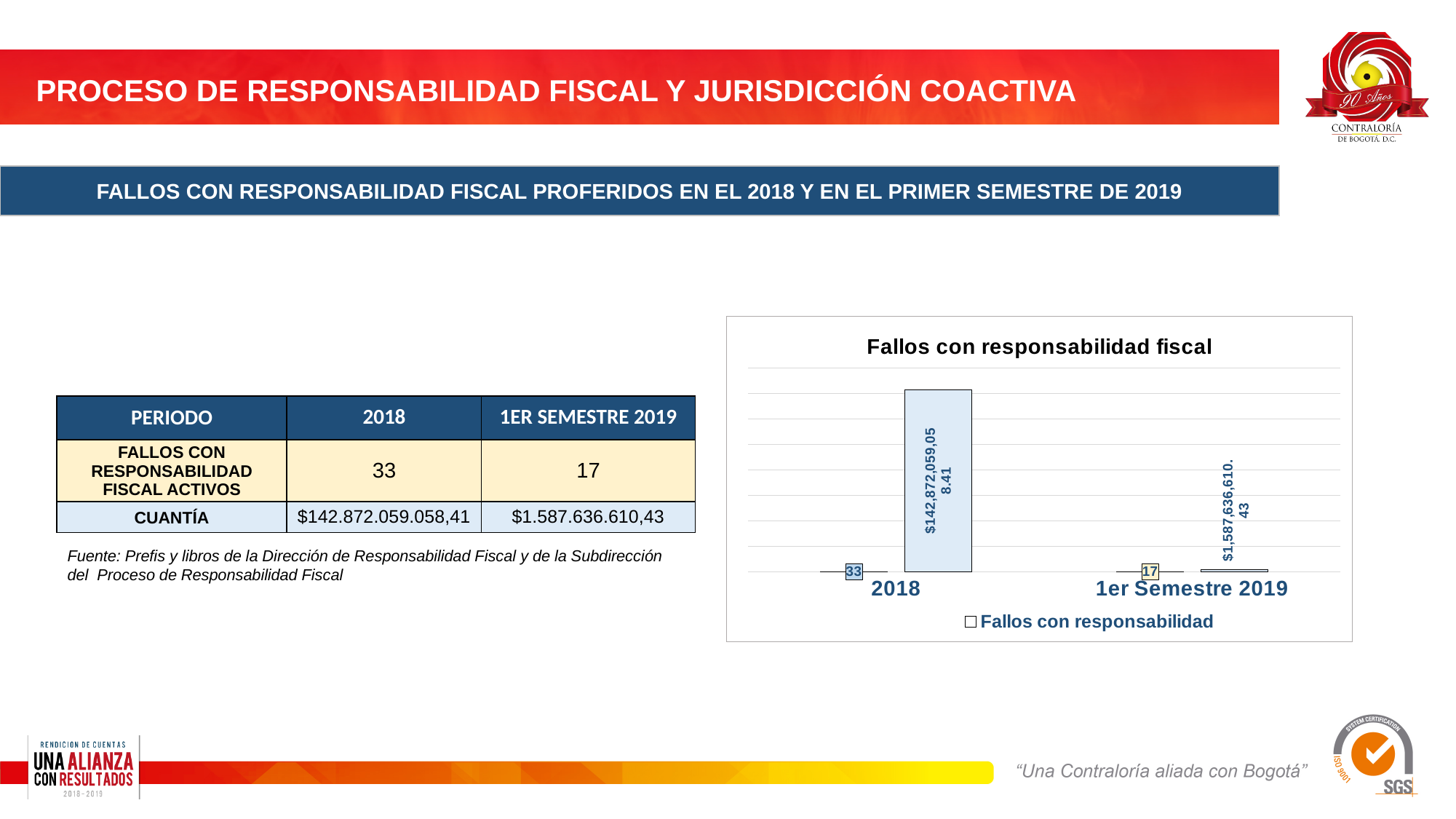
In the chart 'Fallos con responsabilidad fiscal', what is the number of fallos shown for 2018? 33 In the chart 'Fallos con responsabilidad fiscal', what cuantía value is labelled on the tall bar for 2018? $142,872,059,058.41 In the chart 'Fallos con responsabilidad fiscal', which period has the larger cuantía bar, 2018 or 1er Semestre 2019? 2018 How many entries does the legend of the chart 'Fallos con responsabilidad fiscal' list? 1 In the chart 'Fallos con responsabilidad fiscal', do the values rise or fall from 2018 to 1er Semestre 2019? Fall What kind of chart is 'Fallos con responsabilidad fiscal'? Bar chart In the chart 'Fallos con responsabilidad fiscal', what is the difference between the number of fallos in 2018 and in 1er Semestre 2019? 16 In the chart 'Fallos con responsabilidad fiscal', what cuantía value is labelled for 1er Semestre 2019? $1,587,636,610.43 How many periods (categories) are shown on the x axis of the chart 'Fallos con responsabilidad fiscal'? 2 In the chart 'Fallos con responsabilidad fiscal', which period has the higher number of fallos? 2018 In the chart 'Fallos con responsabilidad fiscal', what is the number of fallos shown for 1er Semestre 2019? 17 In the chart 'Fallos con responsabilidad fiscal', which period has the lower number of fallos? 1er Semestre 2019